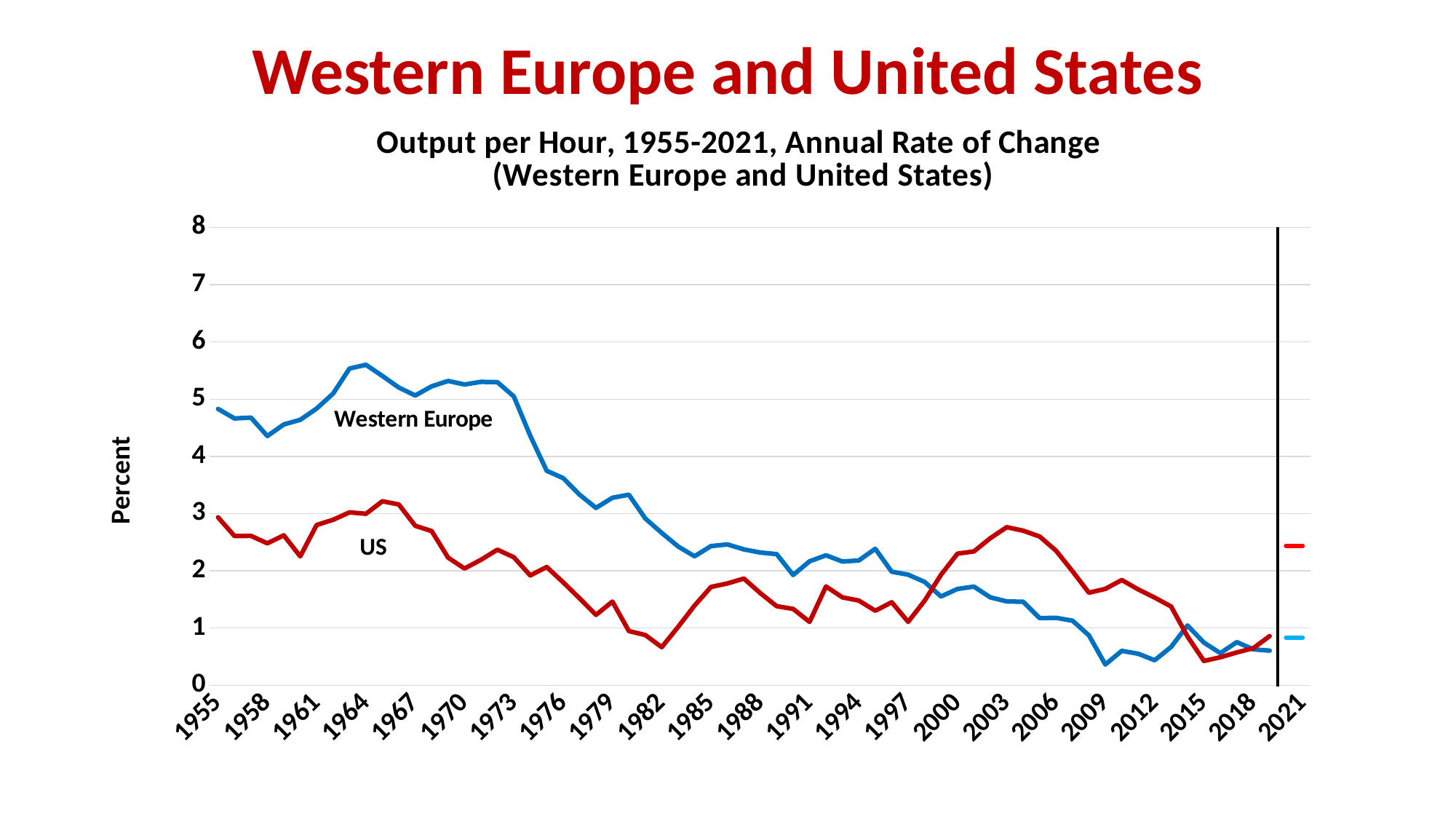
How many year labels are shown on the horizontal axis? 23 Is the value for the US in 2003 greater or less than 2? greater What is the label on the vertical axis of the chart? Percent Is the value for the US in 1982 greater or less than 1? less Is the value for Western Europe in 2009 greater or less than 1? less Overall, does the Western Europe line rise or fall from 1955 to 2021? fall What is the subtitle printed above the chart? Output per Hour, 1955-2021, Annual Rate of Change (Western Europe and United States) In 1964, which series has the higher value, Western Europe or the US? Western Europe In 2003, which series has the higher value, Western Europe or the US? US What kind of chart is shown on the slide? line chart How many series are plotted on the chart? 4